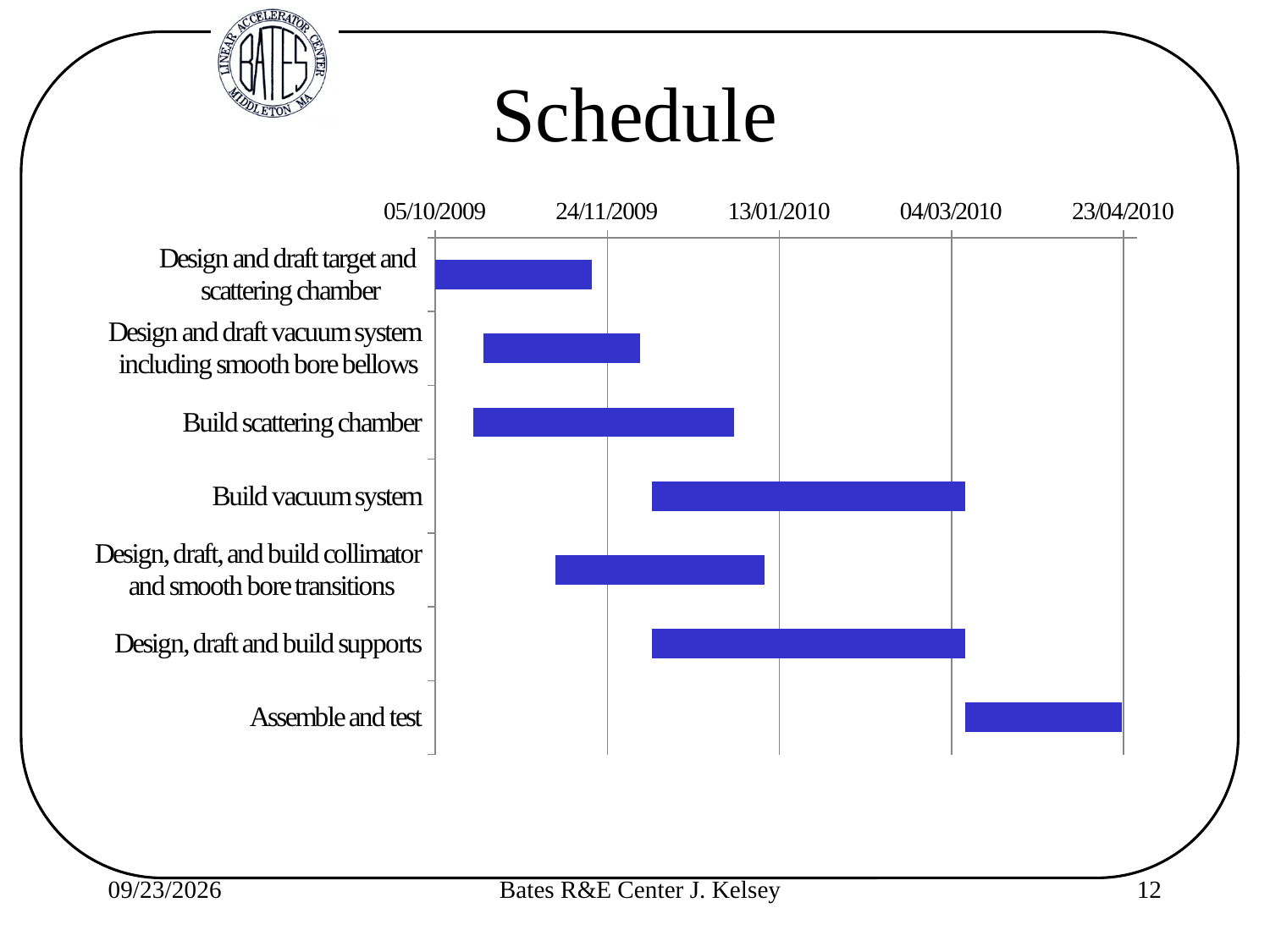
What is the earliest date shown on the chart's time axis? 05/10/2009 How many tasks are listed on the schedule chart? 7 Which task starts earlier, 'Build scattering chamber' or 'Build vacuum system'? Build scattering chamber Which task is scheduled last on the chart? Assemble and test Does the task 'Build scattering chamber' finish before or after 13/01/2010? before What is the title of the slide containing the chart? Schedule Which task ends later, 'Build scattering chamber' or 'Design, draft and build supports'? Design, draft and build supports Does the task 'Design and draft target and scattering chamber' finish before or after 24/11/2009? before Does the task 'Build vacuum system' start before or after 24/11/2009? after Which task starts earliest on the chart? Design and draft target and scattering chamber What is the latest date shown on the chart's time axis? 23/04/2010 What kind of chart is shown on the slide? bar chart (Gantt chart)